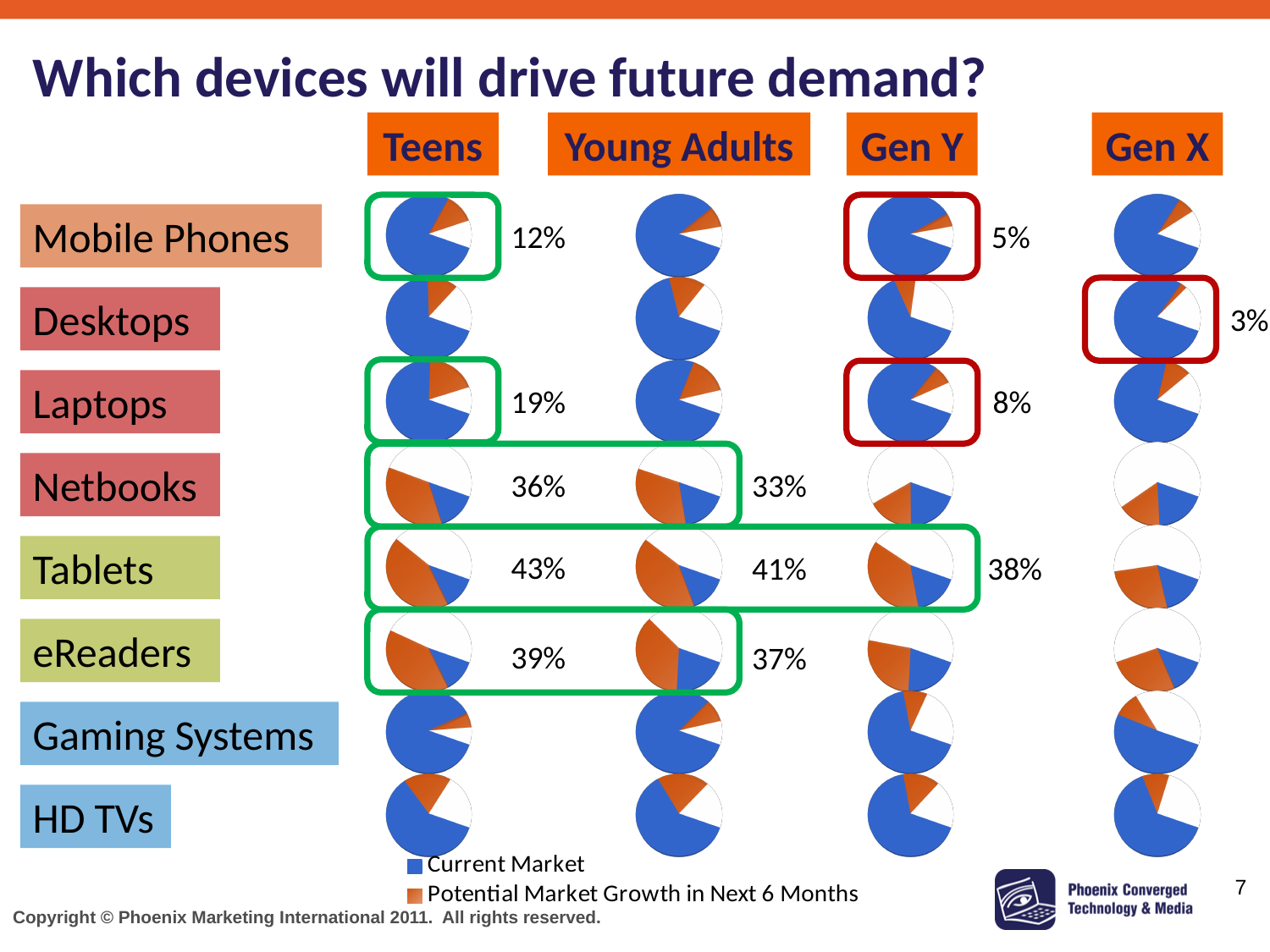
Among the labelled percentages in the Teens column, which device has the highest value? Tablets What percentage is shown next to the Desktops pie chart in the Gen X column? 3% Which is larger: the Netbooks percentage for Teens or for Young Adults? Teens What percentage is shown next to the Mobile Phones pie chart in the Gen Y column? 5% How many series does the legend list? 2 How many device categories are listed down the left side of the slide? 8 Among the labelled percentages in the Gen Y column, which device has the lowest value? Mobile Phones What percentage is shown next to the Laptops pie chart in the Teens column? 19% What kind of chart is used to show each device and age group combination? Pie chart What percentage is shown next to the Tablets pie chart in the Teens column? 43% What is the difference between the Tablets percentage for Teens (43%) and for Gen Y (38%)? 5% What percentage is shown next to the eReaders pie chart in the Young Adults column? 37%